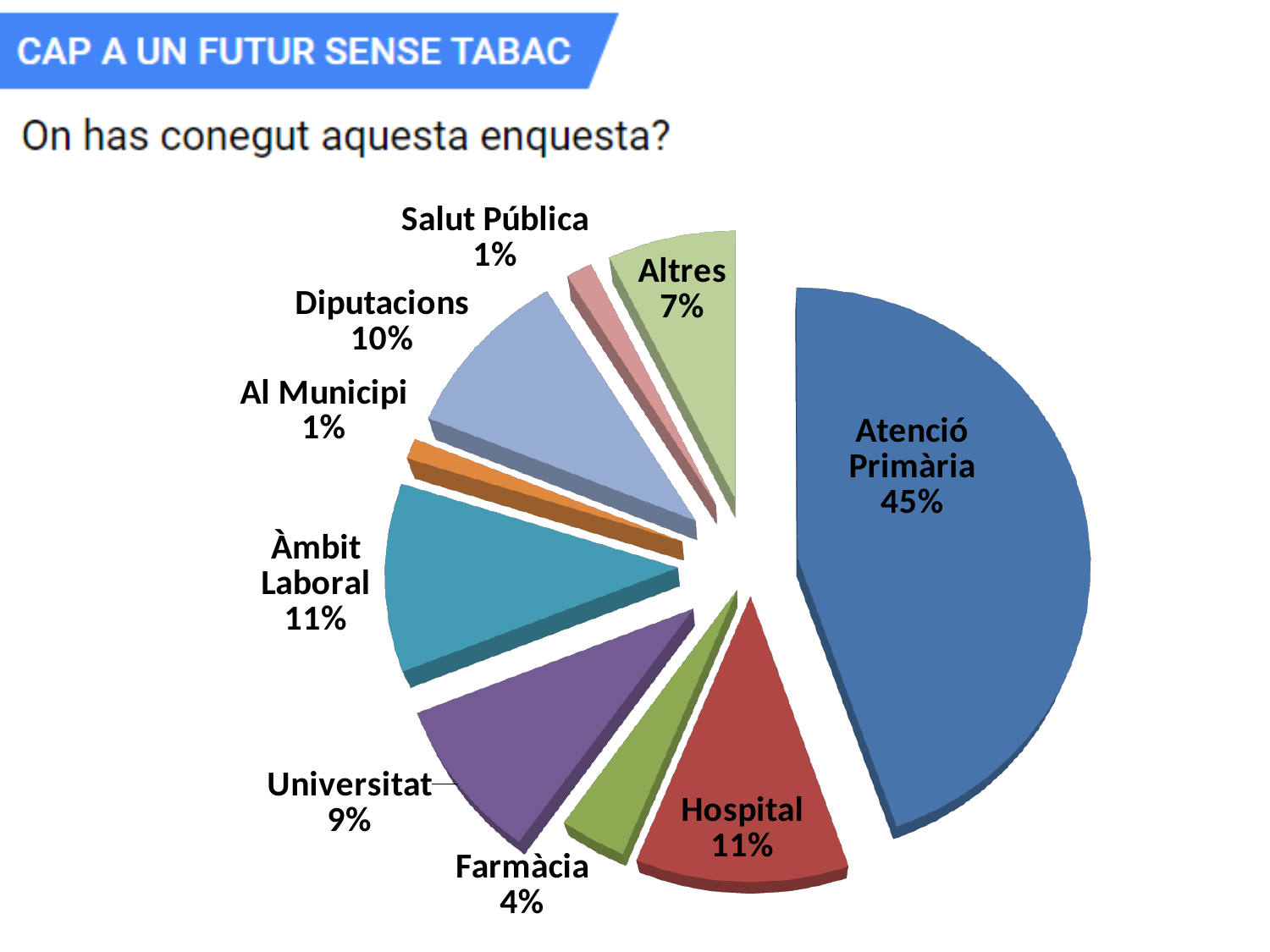
What kind of chart is shown on the slide? pie chart Which is larger, the share for Universitat or the share for Farmàcia? Universitat What is the value shown for Hospital? 11% Which category has the largest slice of the pie? Atenció Primària What is the value shown for Altres? 7% What is the difference between the shares of Diputacions and Altres? 3% What share of the pie does Atenció Primària have? 45% How many slices does the pie chart have? 9 What is the difference between the shares of Atenció Primària and Hospital? 34% What is the value shown for Farmàcia? 4% What is the value shown for Diputacions? 10% What question is the chart answering, according to the text above it? On has conegut aquesta enquesta?